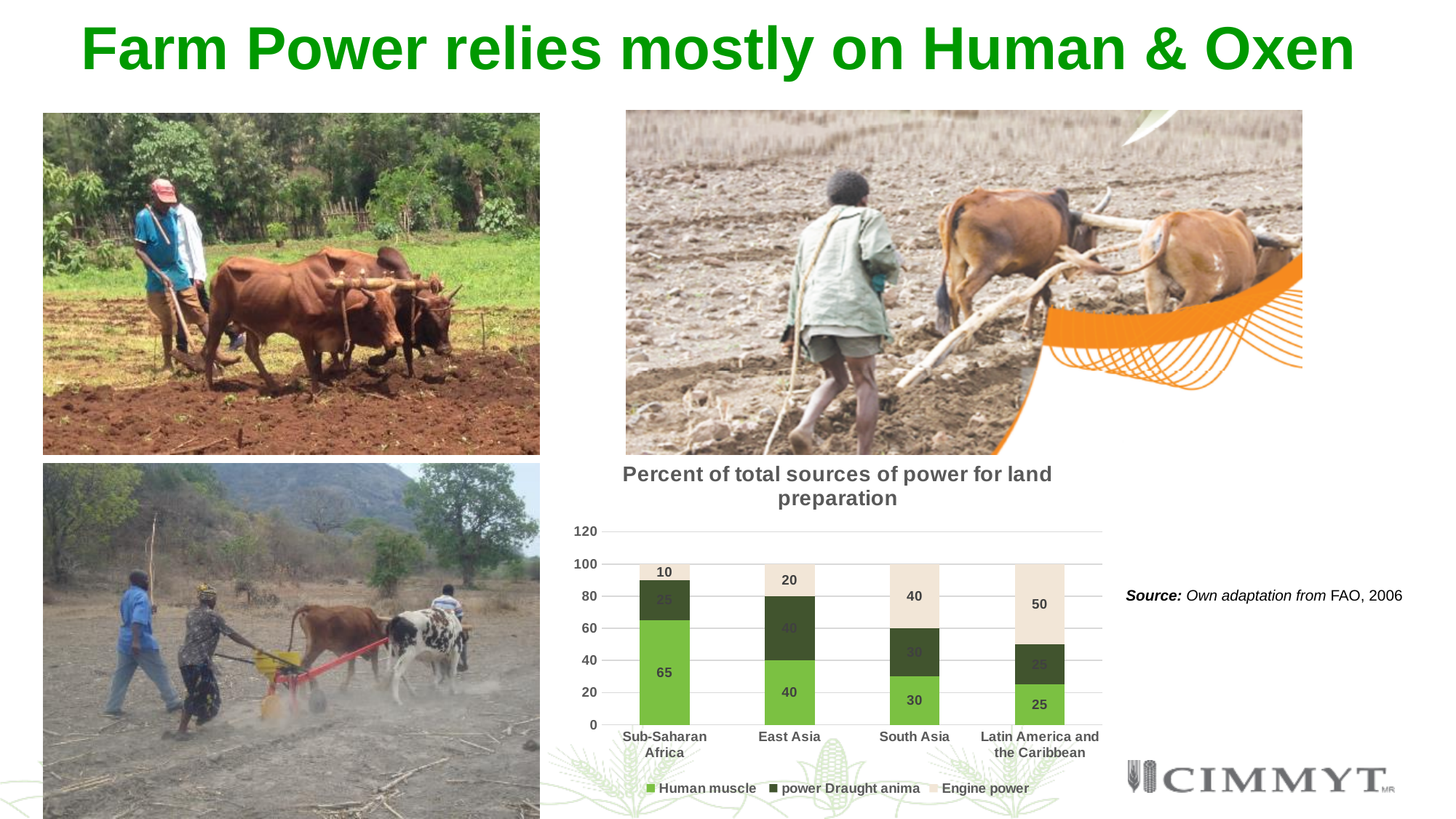
What type of chart is shown under the title 'Percent of total sources of power for land preparation'? stacked bar chart Which region has the highest Human muscle value? Sub-Saharan Africa What is the Human muscle value for Sub-Saharan Africa? 65 What is the total of the stacked bar for Latin America and the Caribbean? 100 What is the Engine power value for Latin America and the Caribbean? 50 Which region has the lowest Engine power value? Sub-Saharan Africa How many regions are shown on the x axis of the chart? 4 What is the Human muscle value for South Asia? 30 Is the Engine power value larger for South Asia or for East Asia? South Asia What is the difference between the Human muscle values for Sub-Saharan Africa and East Asia? 25 How many series does the chart legend list? 3 What is the Engine power value for East Asia? 20